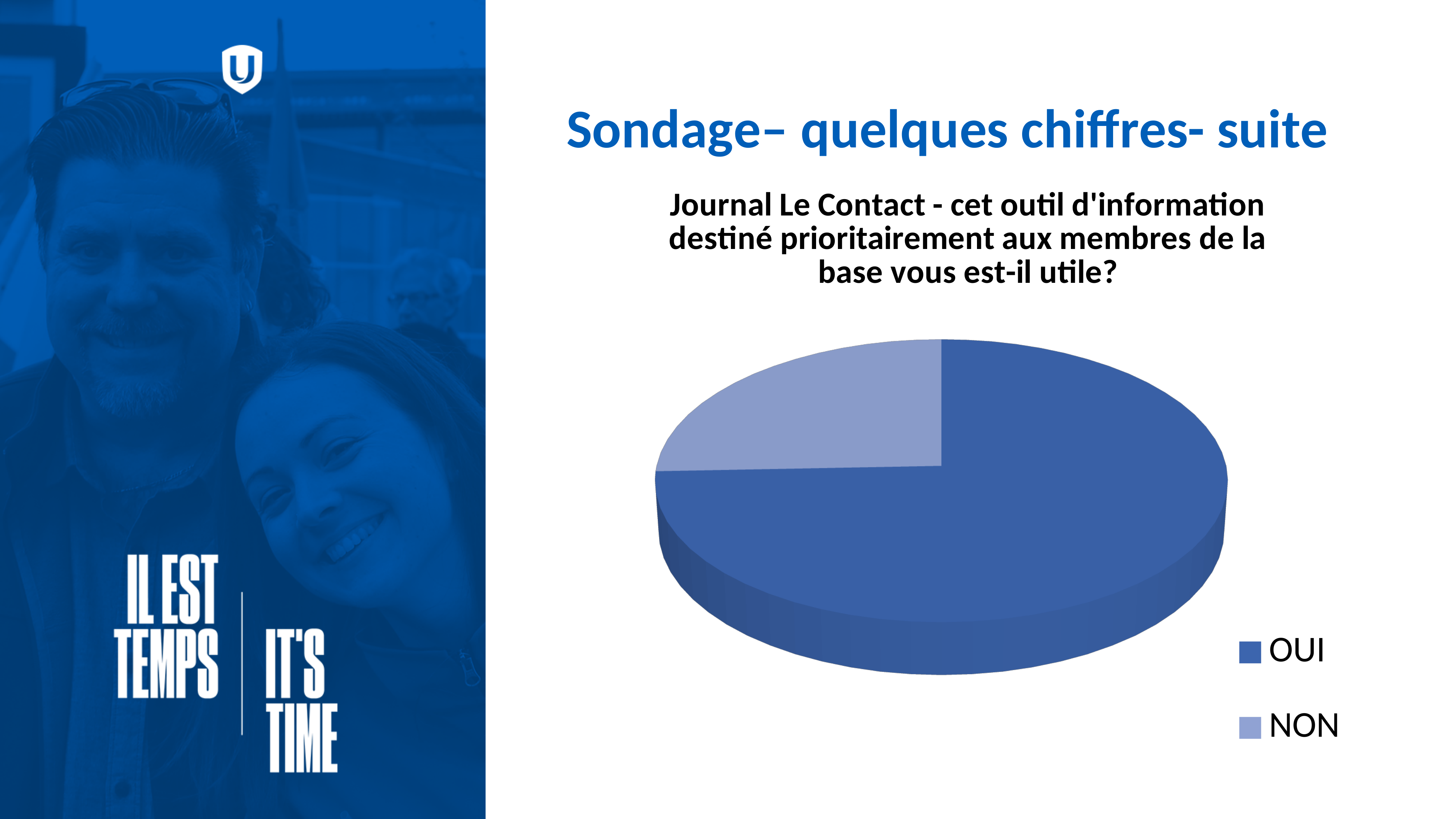
Which legend entry is shown in the lighter blue colour? NON What is the title of the pie chart? Journal Le Contact - cet outil d'information destiné prioritairement aux membres de la base vous est-il utile? Which is larger in the pie chart, OUI or NON? OUI How many slices does the pie chart have? 2 How many entries does the legend of the pie chart list? 2 What kind of chart is shown on the slide? pie chart Which slice of the pie chart is the largest? OUI Which slice of the pie chart is the smallest? NON